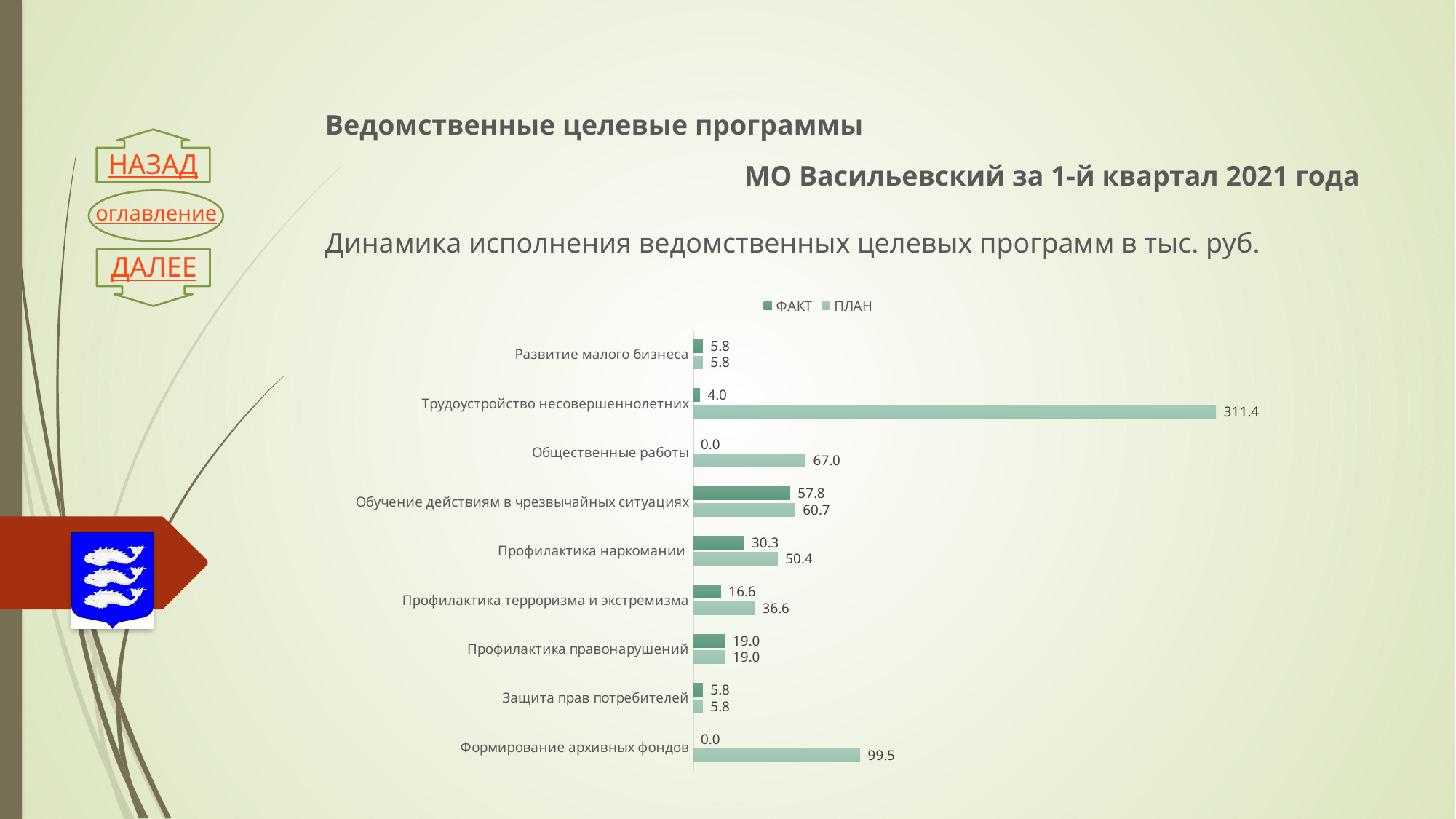
Which is larger for Общественные работы, the ФАКТ value or the ПЛАН value? ПЛАН How many categories are shown on the chart? 9 What are the two series named in the legend? ФАКТ and ПЛАН Which category has the highest ПЛАН value? Трудоустройство несовершеннолетних What is the ПЛАН value for Трудоустройство несовершеннолетних? 311.4 What kind of chart is shown on the slide? Bar chart What is the ФАКТ value for Обучение действиям в чрезвычайных ситуациях? 57.8 What is the difference between the ПЛАН and ФАКТ values for Профилактика наркомании? 20.1 What is the ПЛАН value for Формирование архивных фондов? 99.5 What is the ФАКТ value for Профилактика терроризма и экстремизма? 16.6 How many series does the legend list? 2 Which category has the highest ФАКТ value? Обучение действиям в чрезвычайных ситуациях